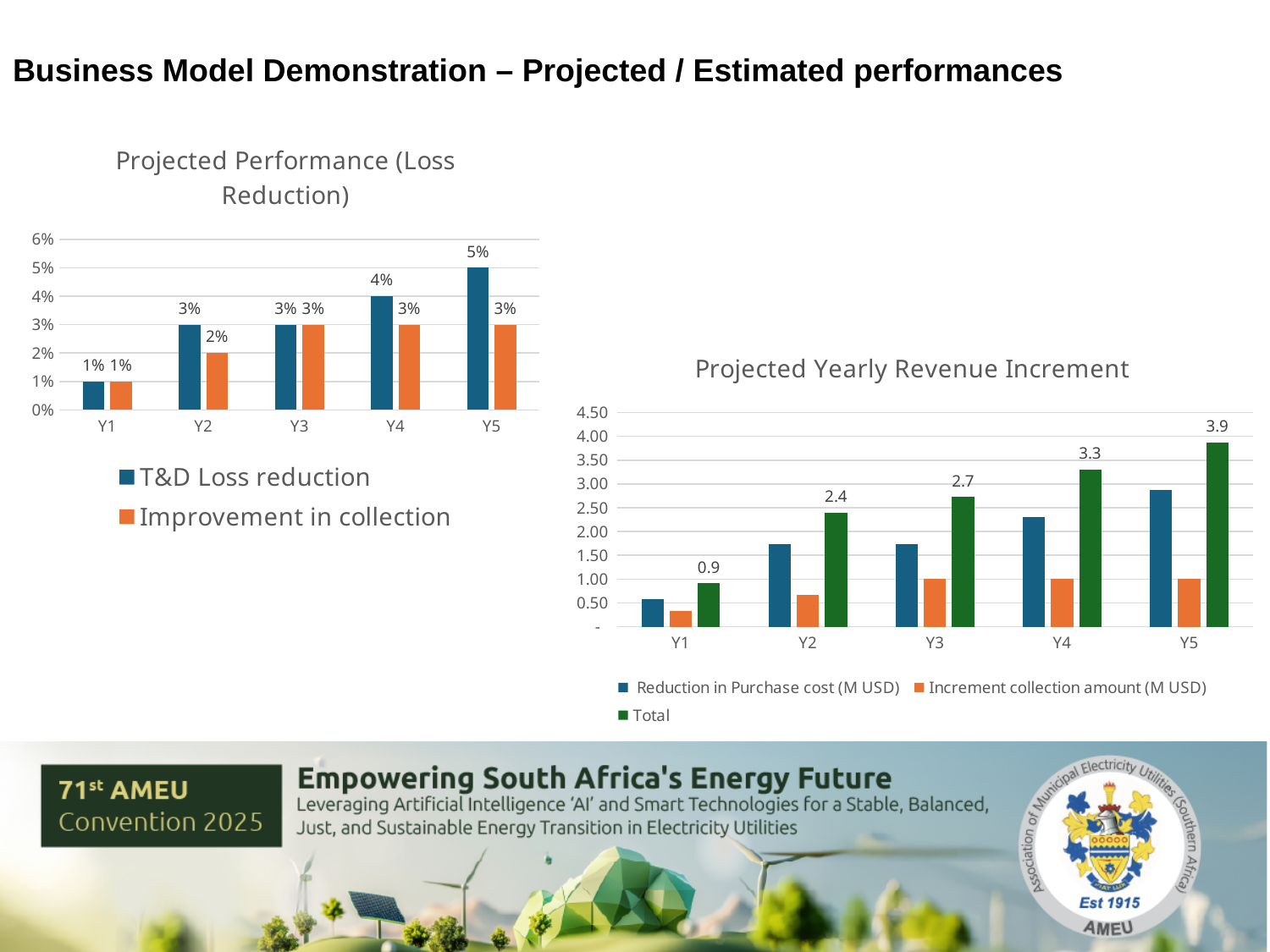
In the Projected Yearly Revenue Increment chart, is the Reduction in Purchase cost (M USD) value for Y5 greater or less than 2.50? greater What kind of chart is the Projected Yearly Revenue Increment chart? bar chart In the Projected Performance (Loss Reduction) chart, what is the T&D Loss reduction value for Y5? 5% In the Projected Performance (Loss Reduction) chart, what is the Improvement in collection value for Y2? 2% In the Projected Yearly Revenue Increment chart, what is the difference between the Total for Y5 and the Total for Y4? 0.6 In the Projected Yearly Revenue Increment chart, what is the Total value for Y3? 2.7 In the Projected Performance (Loss Reduction) chart, which year has the highest T&D Loss reduction? Y5 In the Projected Yearly Revenue Increment chart, what is the Total value for Y1? 0.9 In the Projected Performance (Loss Reduction) chart, does the T&D Loss reduction rise or fall from Y1 to Y5? rise How many series does the legend of the Projected Performance (Loss Reduction) chart list? 2 In the Projected Yearly Revenue Increment chart, which is larger in Y2: Reduction in Purchase cost (M USD) or Increment collection amount (M USD)? Reduction in Purchase cost (M USD) In the Projected Performance (Loss Reduction) chart, what is the difference between T&D Loss reduction and Improvement in collection in Y4? 1%